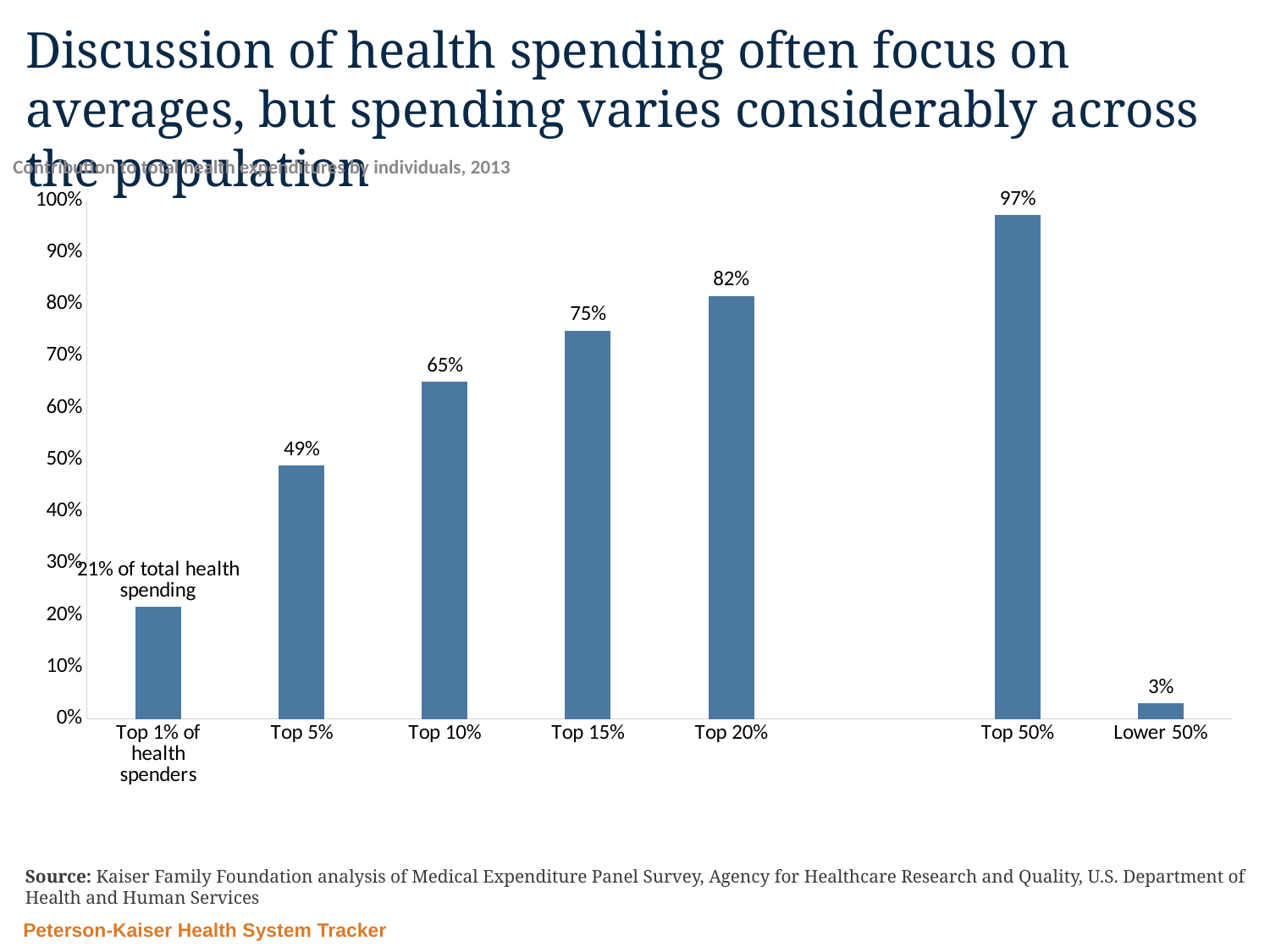
What is the value shown for the Top 1% of health spenders? 21% What is the value shown for the Lower 50% category? 3% What share of total health spending is attributed to the Top 5% of health spenders? 49% What is the difference between the values for Top 50% and Lower 50%? 94% What is the difference between the values for Top 10% and Top 5%? 16% What kind of chart is shown on the slide? Bar chart What is the value shown for the Top 20% category? 82% How many categories are shown on the x axis? 7 Which category has the highest value? Top 50% Do the values rise or fall from Top 1% through Top 50% along the x axis? Rise Which is larger, the value for Top 15% or the value for Top 10%? Top 15% Which category has the lowest value? Lower 50%